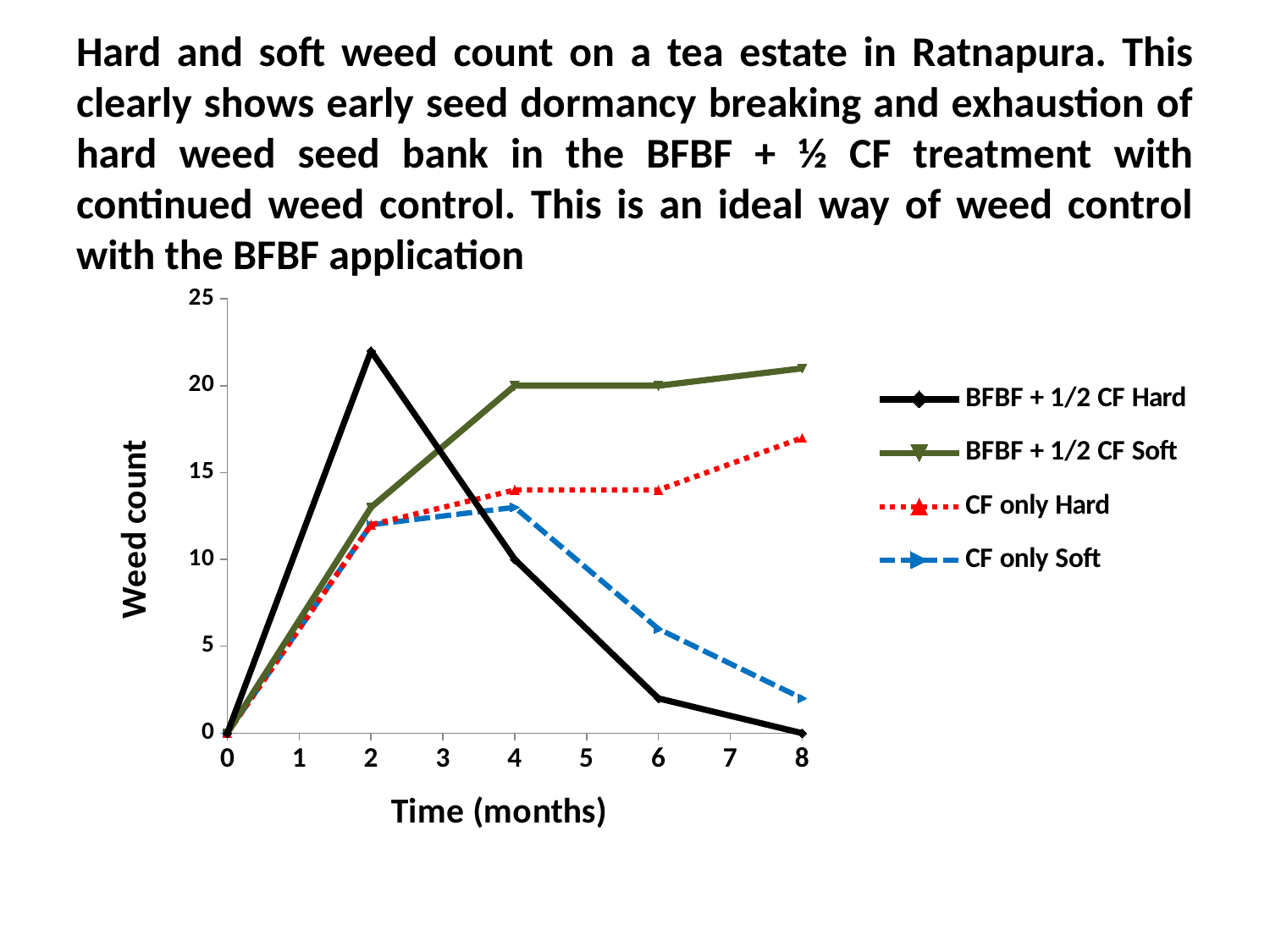
How many time points are plotted for each series? 5 What is the weed count for BFBF + 1/2 CF Hard at 4 months? 10 What kind of chart is shown on the slide? Line chart Is the value for CF only Soft at 8 months greater or less than 5? less Is the value for BFBF + 1/2 CF Hard at 2 months greater or less than 20? greater Which series has the highest weed count at 2 months? BFBF + 1/2 CF Hard Which series has the highest weed count at 8 months? BFBF + 1/2 CF Soft Does the weed count for BFBF + 1/2 CF Hard rise or fall from 2 months to 8 months? Fall Is the value for CF only Hard at 8 months greater or less than 15? greater How many series does the legend list? 4 What is the weed count for BFBF + 1/2 CF Soft at 6 months? 20 What is the weed count for BFBF + 1/2 CF Hard at 8 months? 0